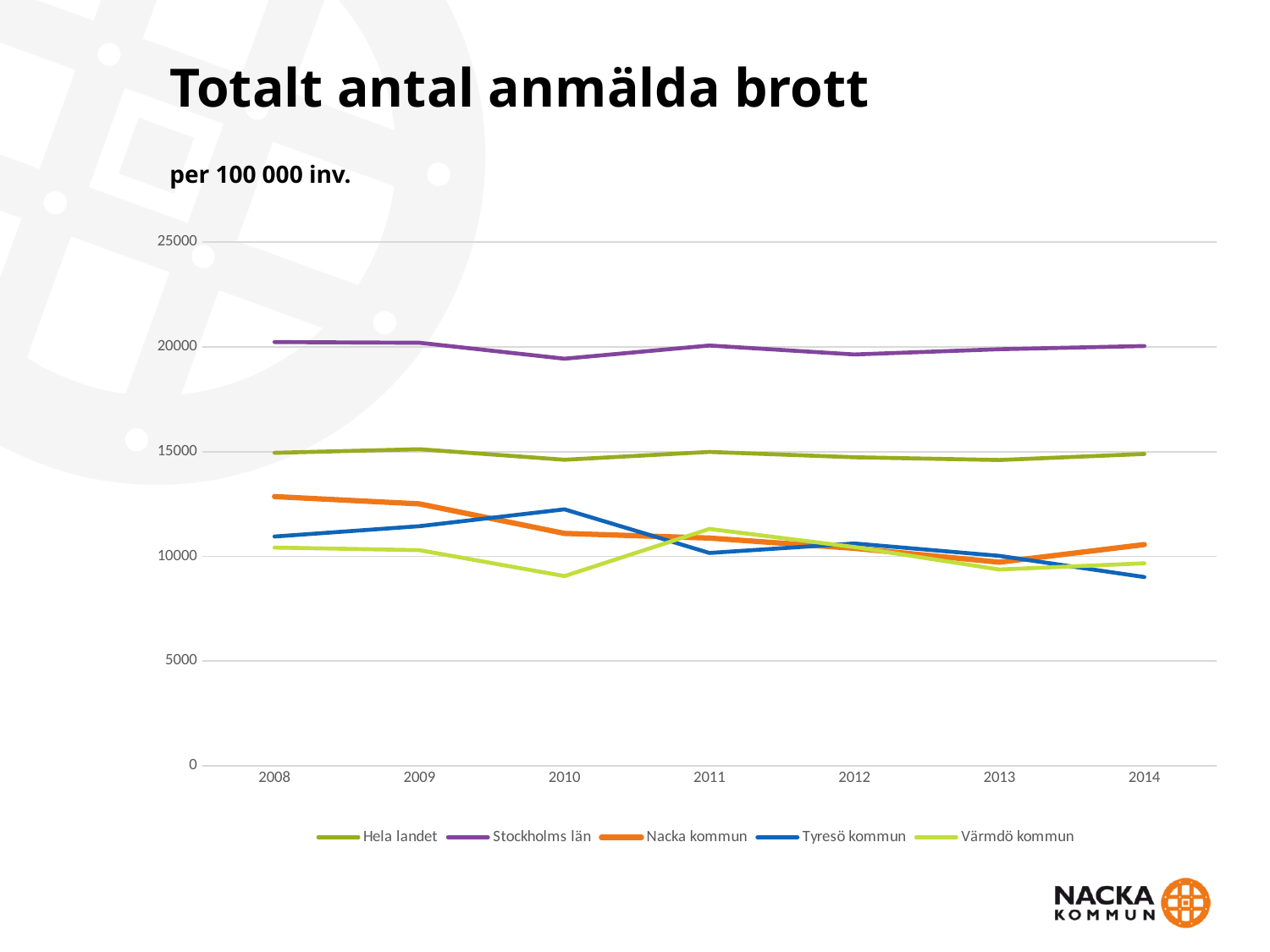
What is the title of the chart? Totalt antal anmälda brott Which series has the lowest value in 2010? Värmdö kommun Which series has the lowest value in 2014? Tyresö kommun Is the value for Tyresö kommun in 2014 greater or less than 10000? less In 2010, which is larger: the value for Tyresö kommun or the value for Nacka kommun? Tyresö kommun Is the value for Stockholms län in 2010 greater or less than 20000? less How many series does the legend list? 5 How many years are plotted along the x axis? 7 What kind of chart is shown on the slide? Line chart Which series has the highest value in 2014? Stockholms län Is the value for Nacka kommun in 2008 greater or less than 10000? greater Does the value for Tyresö kommun rise or fall from 2010 to 2014? Fall